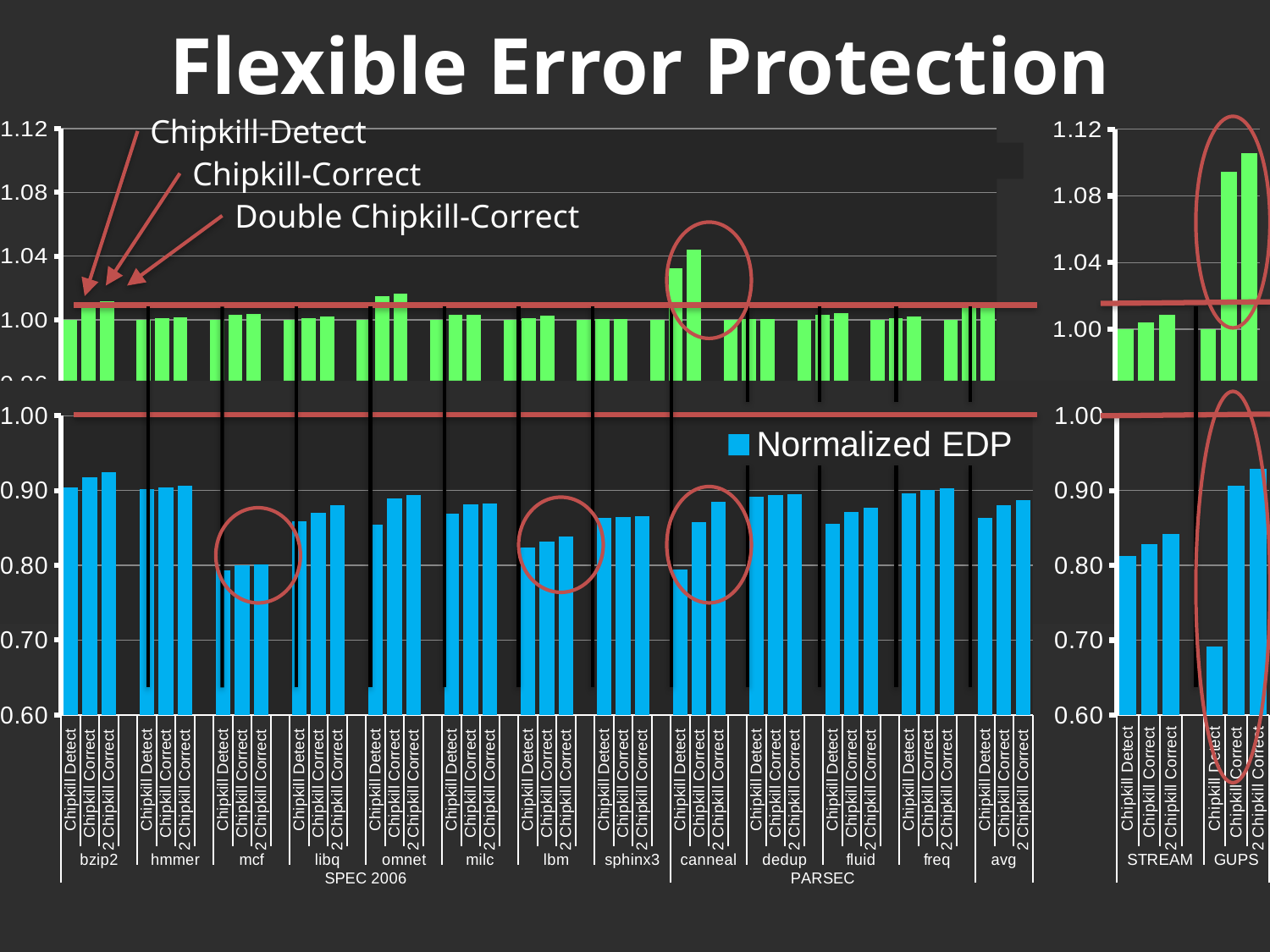
In the bottom-right chart, which bar is the lowest? GUPS Chipkill Detect In the top-right chart, is the 2 Chipkill Correct value for GUPS greater or less than 1.08? greater In the bottom-left Normalized EDP chart, how many benchmark groups (including avg) are shown along the x axis? 13 In the bottom-left Normalized EDP chart, which is larger: the Chipkill Detect value for bzip2 or the Chipkill Detect value for mcf? bzip2 What kind of chart is the bottom-left chart labelled Normalized EDP? bar chart In the bottom-left Normalized EDP chart, do the values for bzip2 rise or fall going from Chipkill Detect to 2 Chipkill Correct? rise What is the legend entry shown in the bottom-left chart? Normalized EDP In the bottom-left Normalized EDP chart, how many series does the legend list? 1 In the bottom-left Normalized EDP chart, is the 2 Chipkill Correct value for bzip2 greater or less than 0.90? greater In the bottom-left Normalized EDP chart, how many bars are plotted for each benchmark? 3